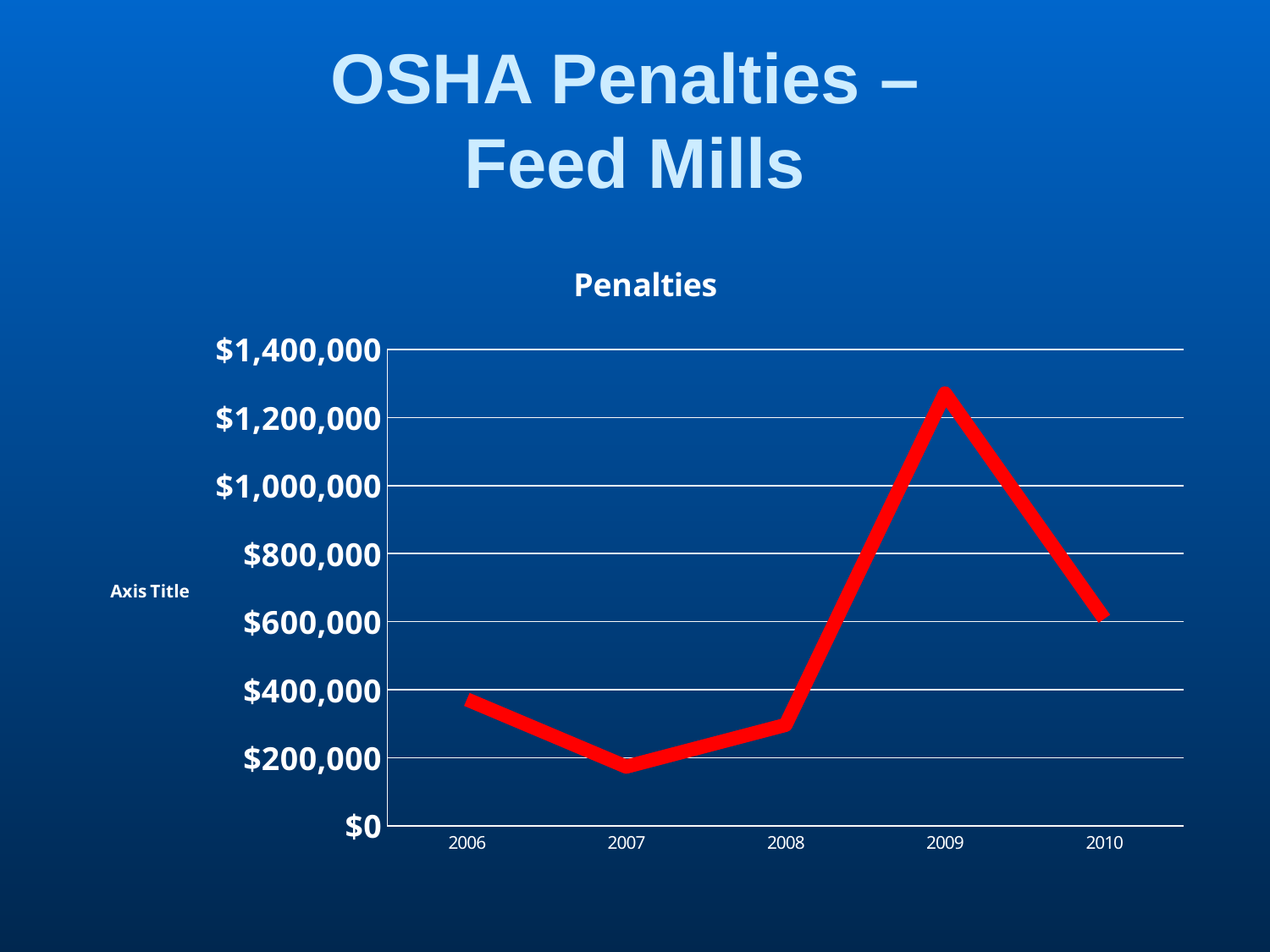
Is the penalties value for 2009 greater or less than $1,000,000? greater Is the penalties value for 2006 greater or less than $400,000? less Which year has a higher penalties value, 2009 or 2010? 2009 Which year has the lowest penalties value? 2007 What kind of chart is shown on the slide? line chart Which year has a higher penalties value, 2006 or 2008? 2006 Is the penalties value for 2010 greater or less than $800,000? less How many years are plotted on the x axis of the Penalties chart? 5 What is the title of the chart? Penalties Which year has the highest penalties value? 2009 Do the penalties rise or fall from 2007 to 2009? rise